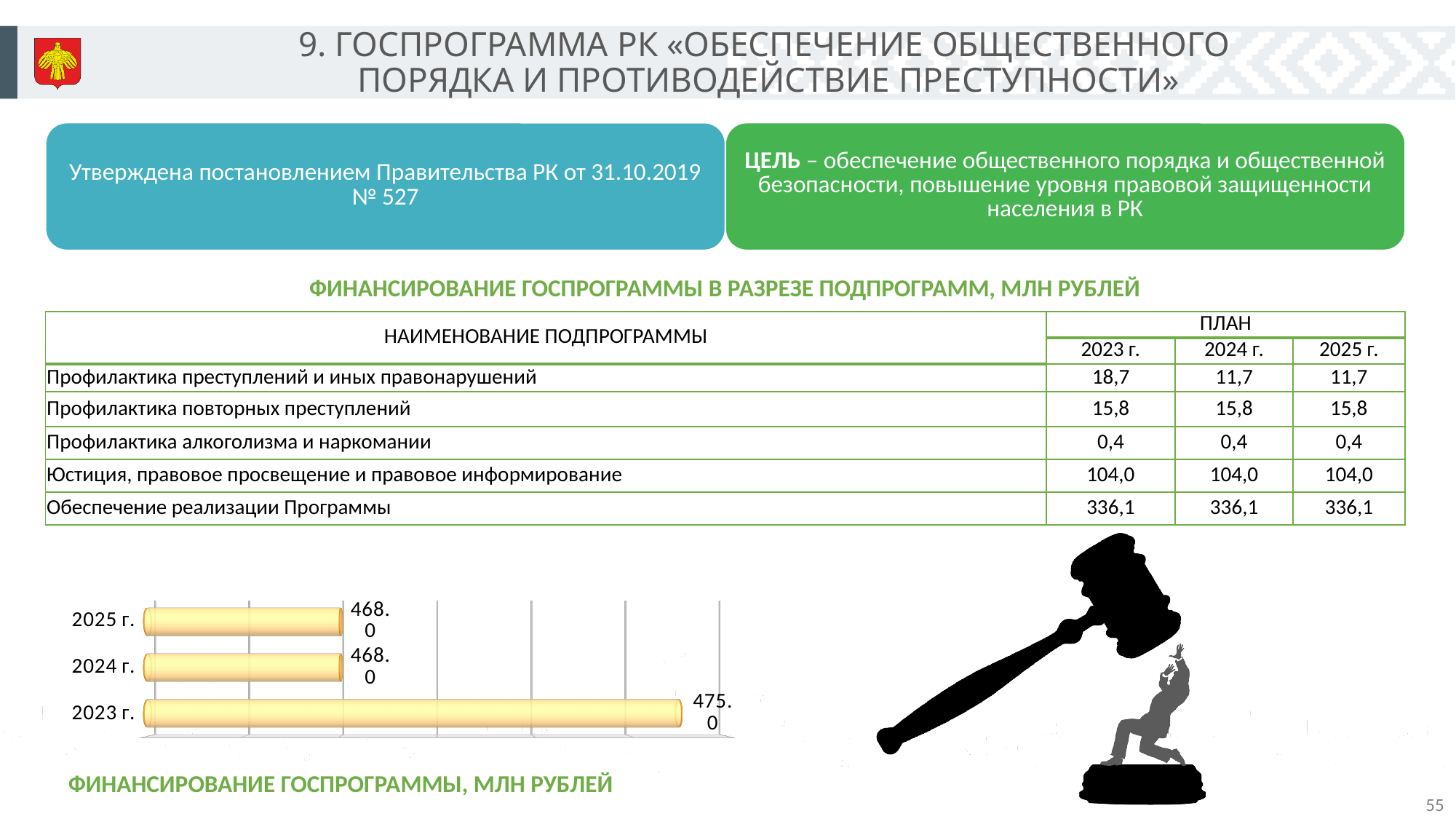
In the chart 'ФИНАНСИРОВАНИЕ ГОСПРОГРАММЫ, МЛН РУБЛЕЙ', which is larger: the value for 2023 г. or the value for 2025 г.? 2023 г. How many bars are shown in the chart 'ФИНАНСИРОВАНИЕ ГОСПРОГРАММЫ, МЛН РУБЛЕЙ'? 3 What is the title of the bar chart at the bottom left of the slide? ФИНАНСИРОВАНИЕ ГОСПРОГРАММЫ, МЛН РУБЛЕЙ What is the value for 2023 г. in the chart 'ФИНАНСИРОВАНИЕ ГОСПРОГРАММЫ, МЛН РУБЛЕЙ'? 475.0 What kind of chart is 'ФИНАНСИРОВАНИЕ ГОСПРОГРАММЫ, МЛН РУБЛЕЙ'? Bar chart In the chart 'ФИНАНСИРОВАНИЕ ГОСПРОГРАММЫ, МЛН РУБЛЕЙ', does the value rise or fall from 2023 г. to 2024 г.? Fall What is the value for 2024 г. in the chart 'ФИНАНСИРОВАНИЕ ГОСПРОГРАММЫ, МЛН РУБЛЕЙ'? 468.0 In the chart 'ФИНАНСИРОВАНИЕ ГОСПРОГРАММЫ, МЛН РУБЛЕЙ', are the values for 2024 г. and 2025 г. equal? Yes Which year has the highest value in the chart 'ФИНАНСИРОВАНИЕ ГОСПРОГРАММЫ, МЛН РУБЛЕЙ'? 2023 г. In the chart 'ФИНАНСИРОВАНИЕ ГОСПРОГРАММЫ, МЛН РУБЛЕЙ', what is the difference between the values for 2023 г. and 2024 г.? 7.0 What is the value for 2025 г. in the chart 'ФИНАНСИРОВАНИЕ ГОСПРОГРАММЫ, МЛН РУБЛЕЙ'? 468.0 What colour are the bars in the chart 'ФИНАНСИРОВАНИЕ ГОСПРОГРАММЫ, МЛН РУБЛЕЙ'? Yellow